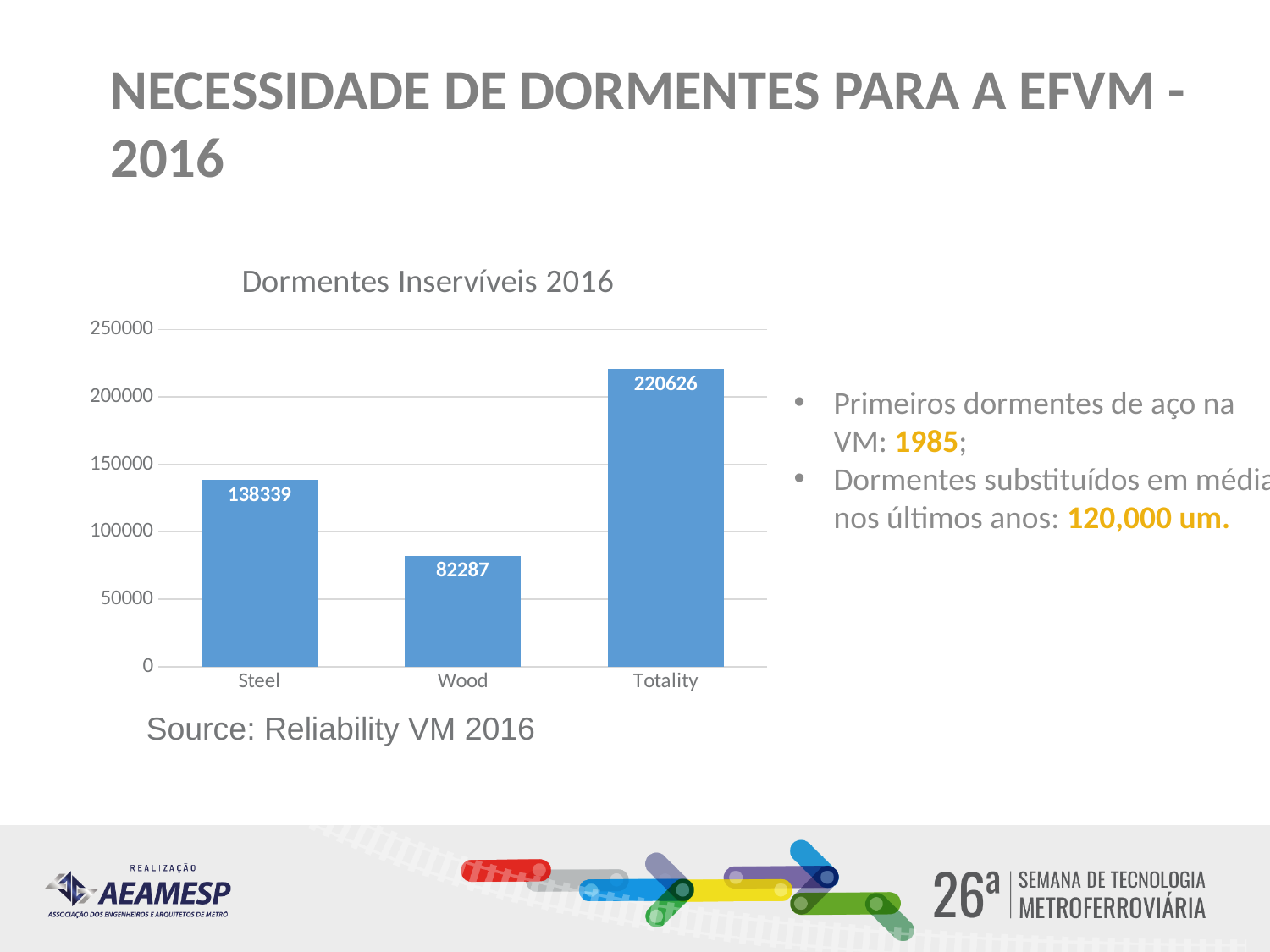
How many categories are shown on the x axis? 3 What is the value for Totality? 220626 What is the difference between the values for Steel and Wood? 56052 What is the value for Steel? 138339 What kind of chart is shown on the slide? bar chart Which category has the lowest value? Wood Is the value for Totality greater or less than 200000? greater What is the value for Wood? 82287 Which category has the highest value? Totality Is the value for Wood greater or less than 100000? less What is the title of the chart? Dormentes Inservíveis 2016 Which is larger, the value for Steel or the value for Wood? Steel